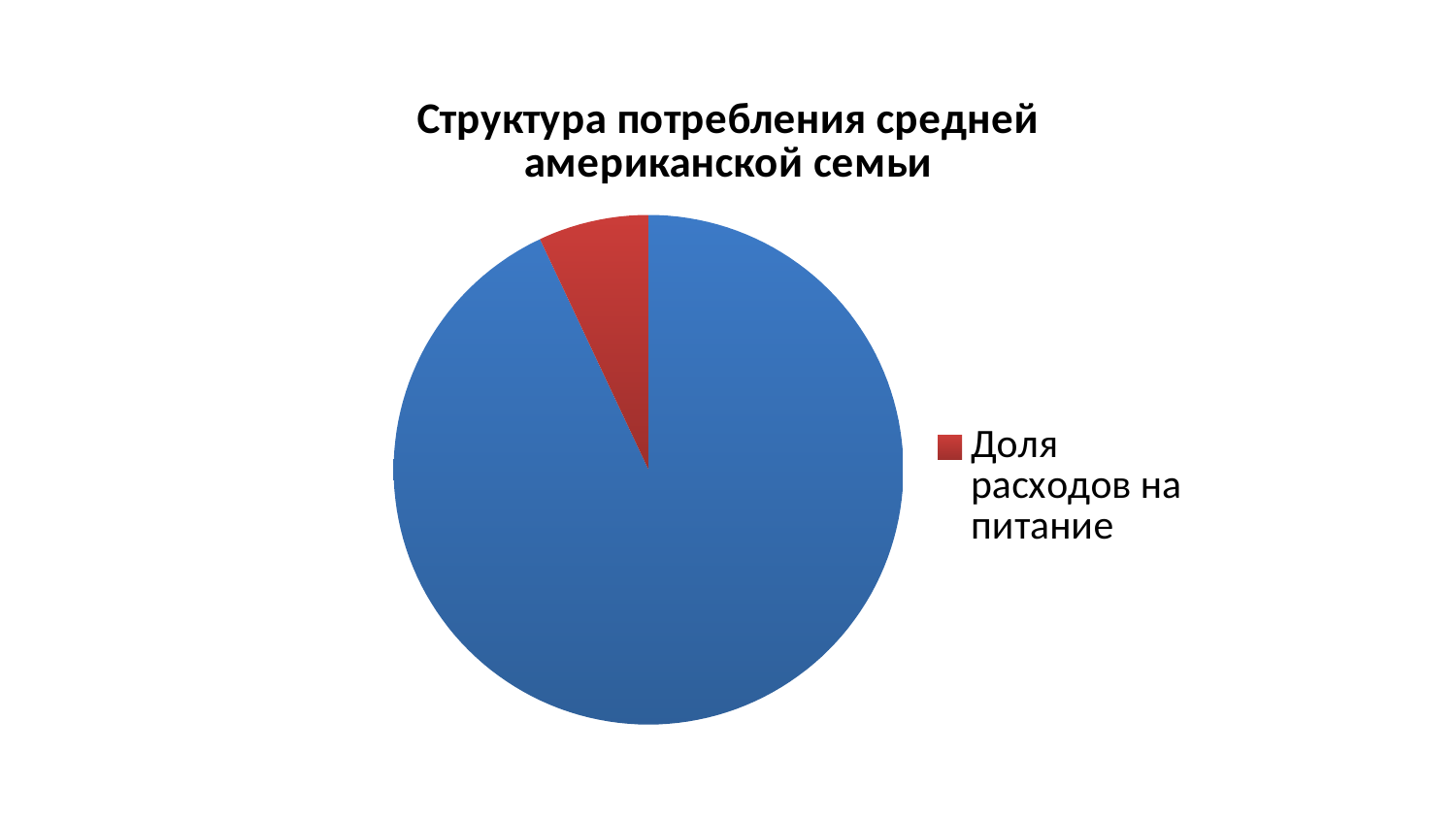
What kind of chart is shown on the slide? pie chart What colour is the slice labeled Доля расходов на питание? red How many slices does the pie chart have? 2 Which slice is the smallest in the pie chart? Доля расходов на питание Is the share of Доля расходов на питание greater or less than 50% of the pie? less What is the title of the chart? Структура потребления средней американской семьи How many entries does the chart's legend list? 1 Is the slice for Доля расходов на питание larger or smaller than the unlabeled blue slice? smaller